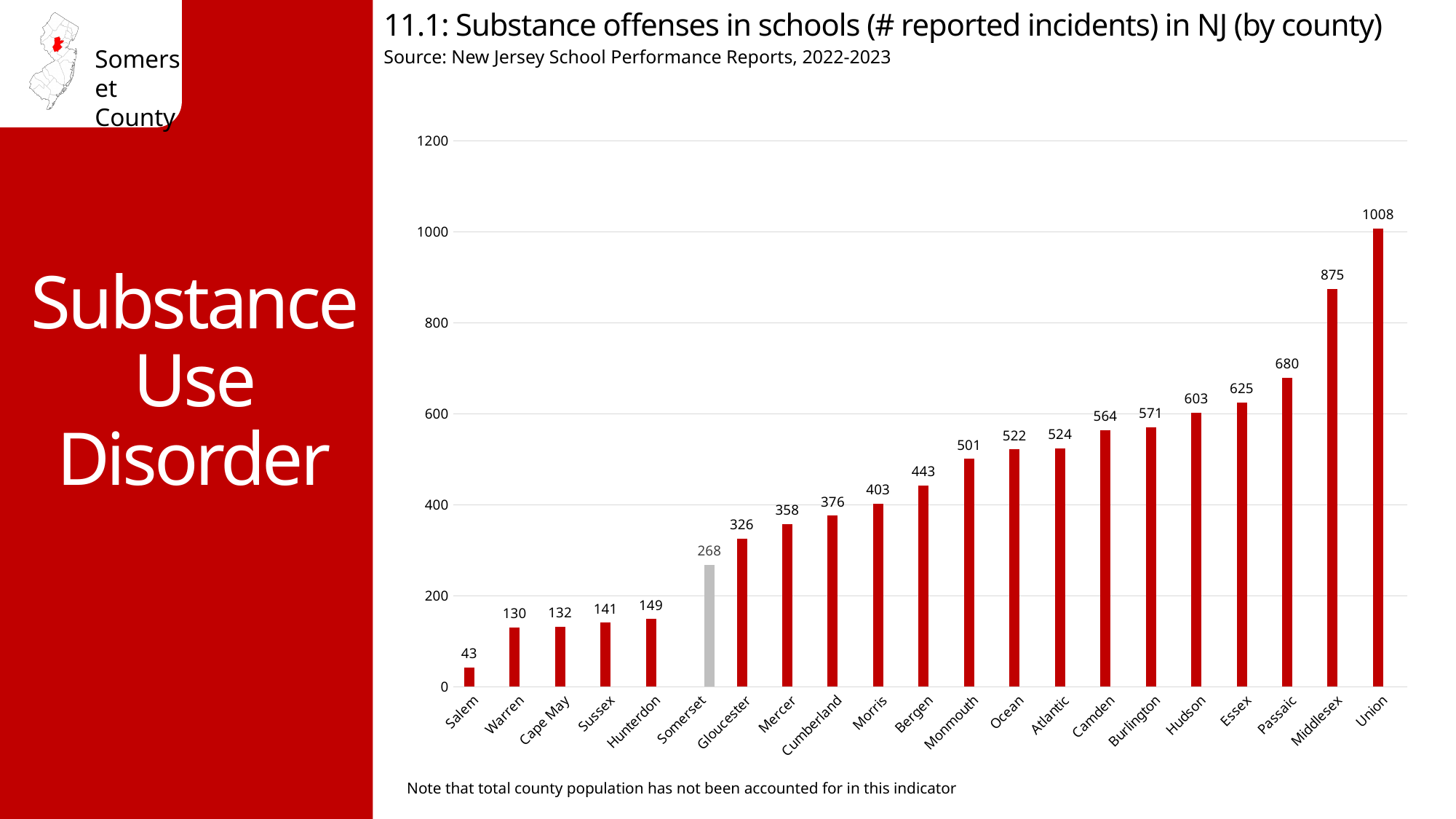
What is the difference between the values for Middlesex and Somerset? 607 Which county's bar is shown in grey rather than red? Somerset Which county has the highest number of reported incidents? Union Is the value for Passaic greater or less than 600? greater How many reported incidents are shown for Bergen County? 443 What is the difference between the values for Hunterdon and Salem? 106 What kind of chart is shown on the slide? Bar chart How many counties are shown on the chart? 21 What is the value shown for Union County? 1008 What is the number of reported substance offense incidents for Somerset County? 268 Which county has the lowest number of reported incidents? Salem Which has a higher value, Essex or Hudson? Essex